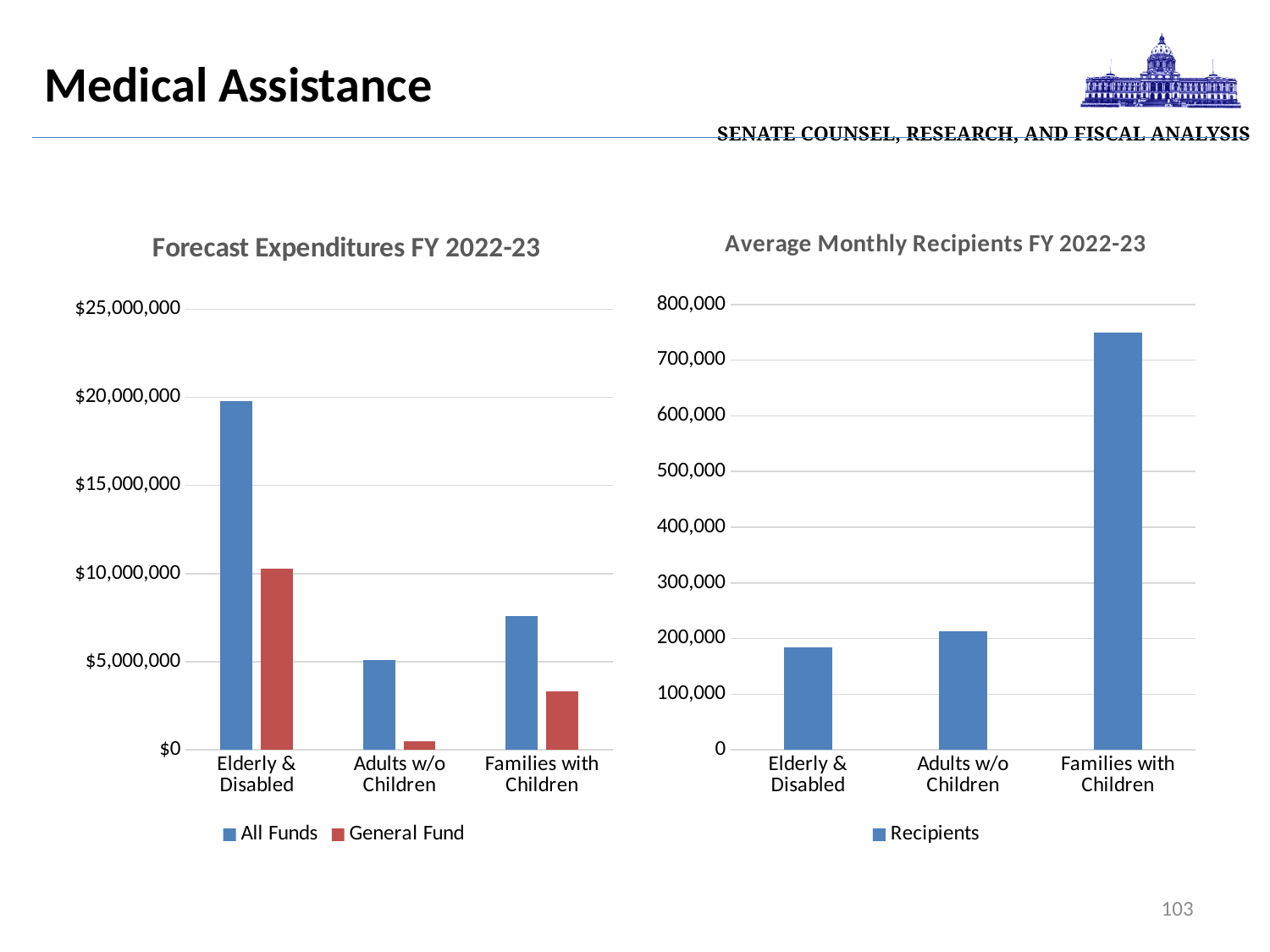
How many categories are shown on the x axis of the Average Monthly Recipients FY 2022-23 chart? 3 In the Forecast Expenditures FY 2022-23 chart, is the All Funds value for Adults w/o Children greater or less than $10,000,000? less In the Forecast Expenditures FY 2022-23 chart, which category has the highest All Funds value? Elderly & Disabled What kind of chart is the Average Monthly Recipients FY 2022-23 chart? bar chart How many series does the legend of the Forecast Expenditures FY 2022-23 chart list? 2 In the Average Monthly Recipients FY 2022-23 chart, is the value for Families with Children greater or less than 700,000? greater In the Forecast Expenditures FY 2022-23 chart, is the General Fund value for Elderly & Disabled greater or less than $5,000,000? greater In the Forecast Expenditures FY 2022-23 chart, which category has the lowest General Fund value? Adults w/o Children In the Forecast Expenditures FY 2022-23 chart, which is larger for Families with Children: All Funds or General Fund? All Funds In the Average Monthly Recipients FY 2022-23 chart, which category has the highest number of recipients? Families with Children